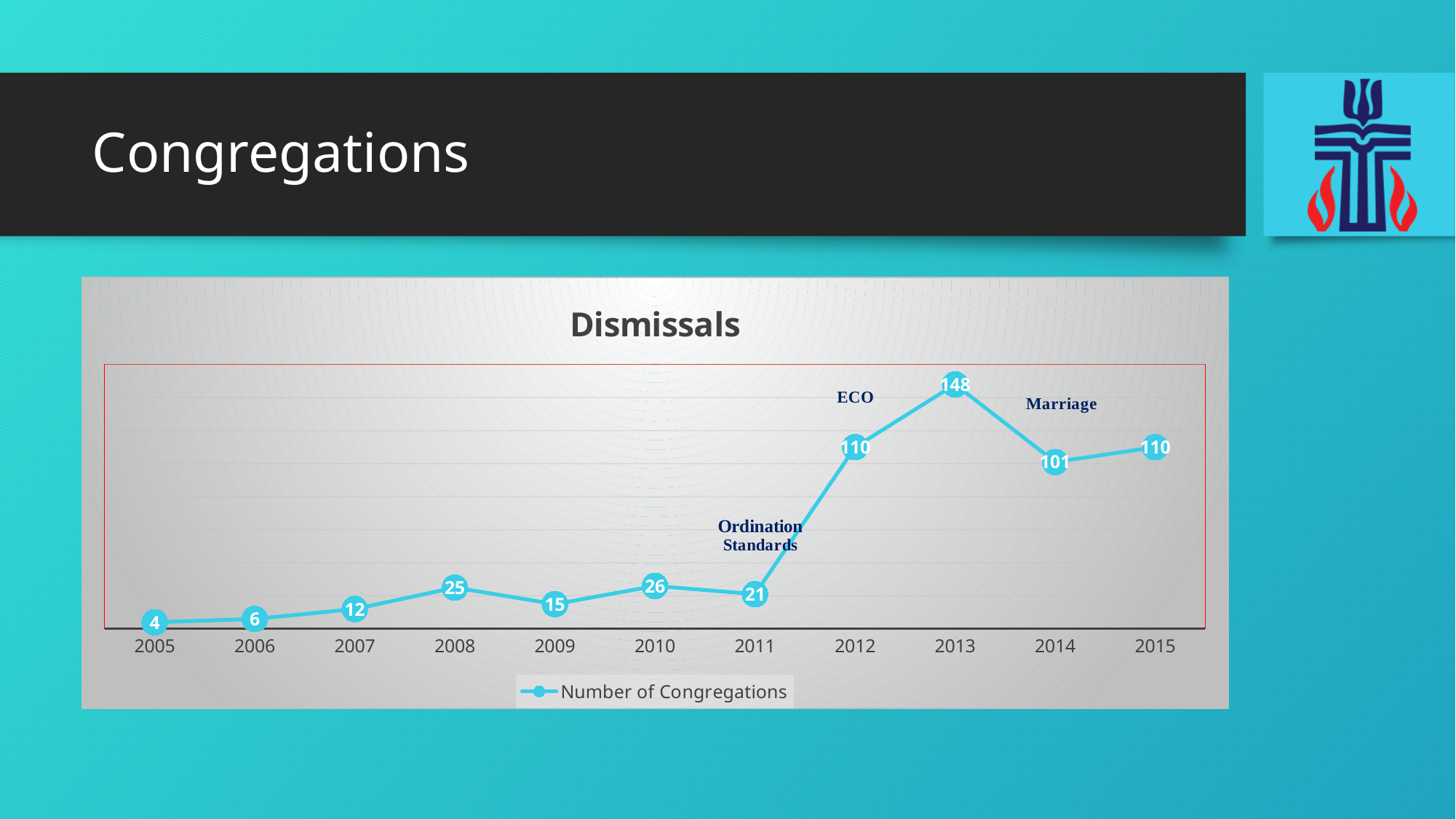
Which is larger in the Dismissals chart, the value for 2010 or the value for 2009? 2010 How many series does the legend of the Dismissals chart list? 1 What is the difference between the values for 2013 and 2014 in the Dismissals chart? 47 How many years are plotted in the Dismissals chart? 11 What is the value for 2012 in the Dismissals chart? 110 What is the value for 2013 in the Dismissals chart? 148 What is the difference between the values for 2012 and 2011 in the Dismissals chart? 89 What is the value for 2005 in the Dismissals chart? 4 What kind of chart is the Dismissals chart? line chart Which year has the lowest number of congregations in the Dismissals chart? 2005 What is the name of the series in the legend of the Dismissals chart? Number of Congregations Which year has the highest number of congregations in the Dismissals chart? 2013